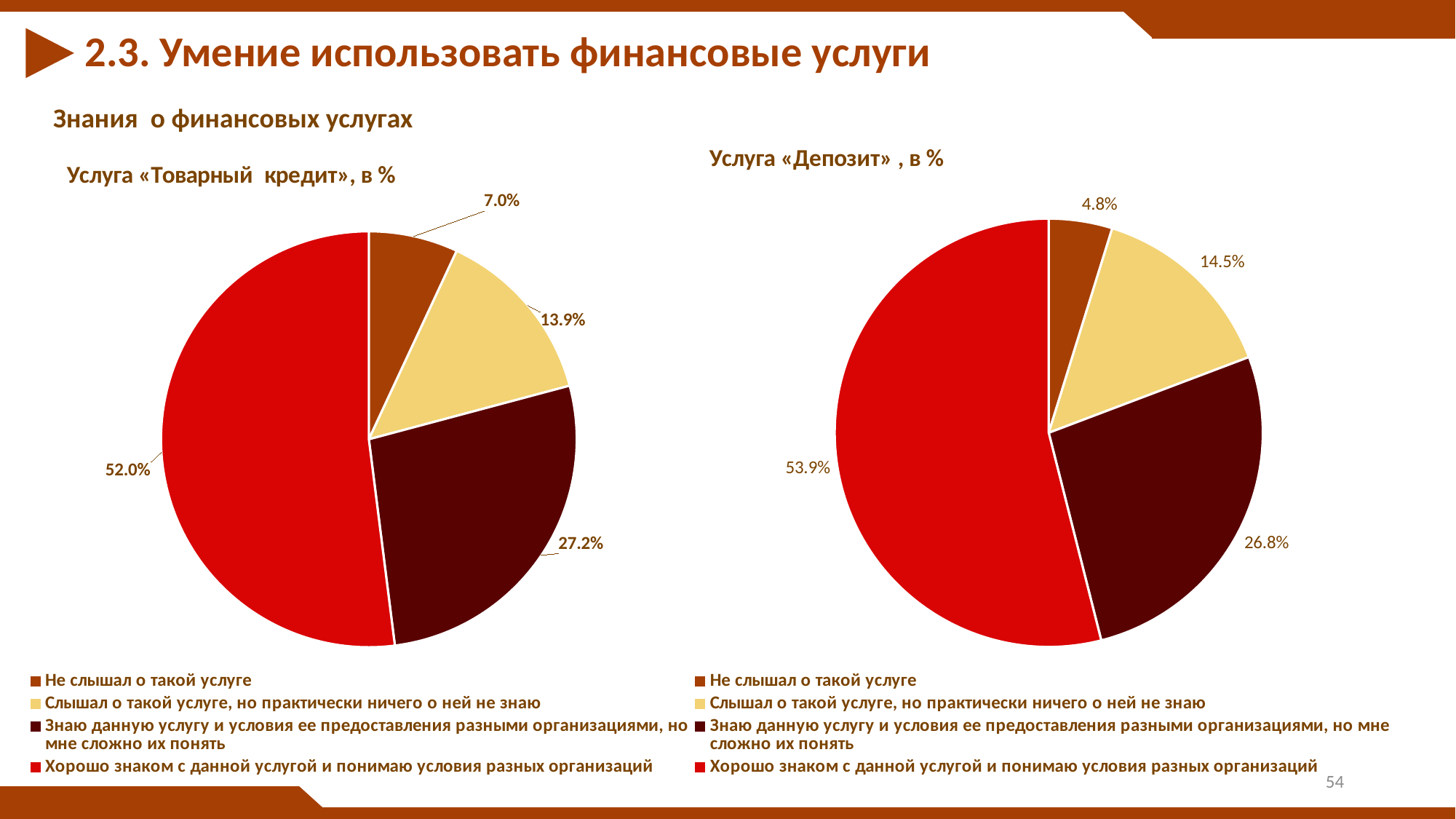
In the chart «Услуга «Депозит», в %», what is the difference between the values for «Хорошо знаком с данной услугой и понимаю условия разных организаций» and «Знаю данную услугу и условия ее предоставления разными организациями, но мне сложно их понять»? 27.1% In the chart «Услуга «Депозит», в %», is the value for «Знаю данную услугу и условия ее предоставления разными организациями, но мне сложно их понять» larger or smaller than the value for «Слышал о такой услуге, но практически ничего о ней не знаю»? larger How many slices does the chart «Услуга «Товарный кредит», в %» have? 4 In the chart «Услуга «Товарный кредит», в %», which category has the smallest share? Не слышал о такой услуге In the chart «Услуга «Товарный кредит», в %», what is the difference between the values for «Знаю данную услугу и условия ее предоставления разными организациями, но мне сложно их понять» and «Слышал о такой услуге, но практически ничего о ней не знаю»? 13.3% In the chart «Услуга «Депозит», в %», what is the value for «Не слышал о такой услуге»? 4.8% Which chart has the larger value for «Не слышал о такой услуге»: «Услуга «Товарный кредит», в %» or «Услуга «Депозит», в %»? Услуга «Товарный кредит», в % In the chart «Услуга «Товарный кредит», в %», what is the value for «Хорошо знаком с данной услугой и понимаю условия разных организаций»? 52.0% In the chart «Услуга «Депозит», в %», which category has the largest share? Хорошо знаком с данной услугой и понимаю условия разных организаций What type of chart is «Услуга «Депозит», в %»? pie chart In the chart «Услуга «Товарный кредит», в %», what colour is the slice for «Слышал о такой услуге, но практически ничего о ней не знаю»? yellow In the chart «Услуга «Депозит», в %», what is the value for «Слышал о такой услуге, но практически ничего о ней не знаю»? 14.5%